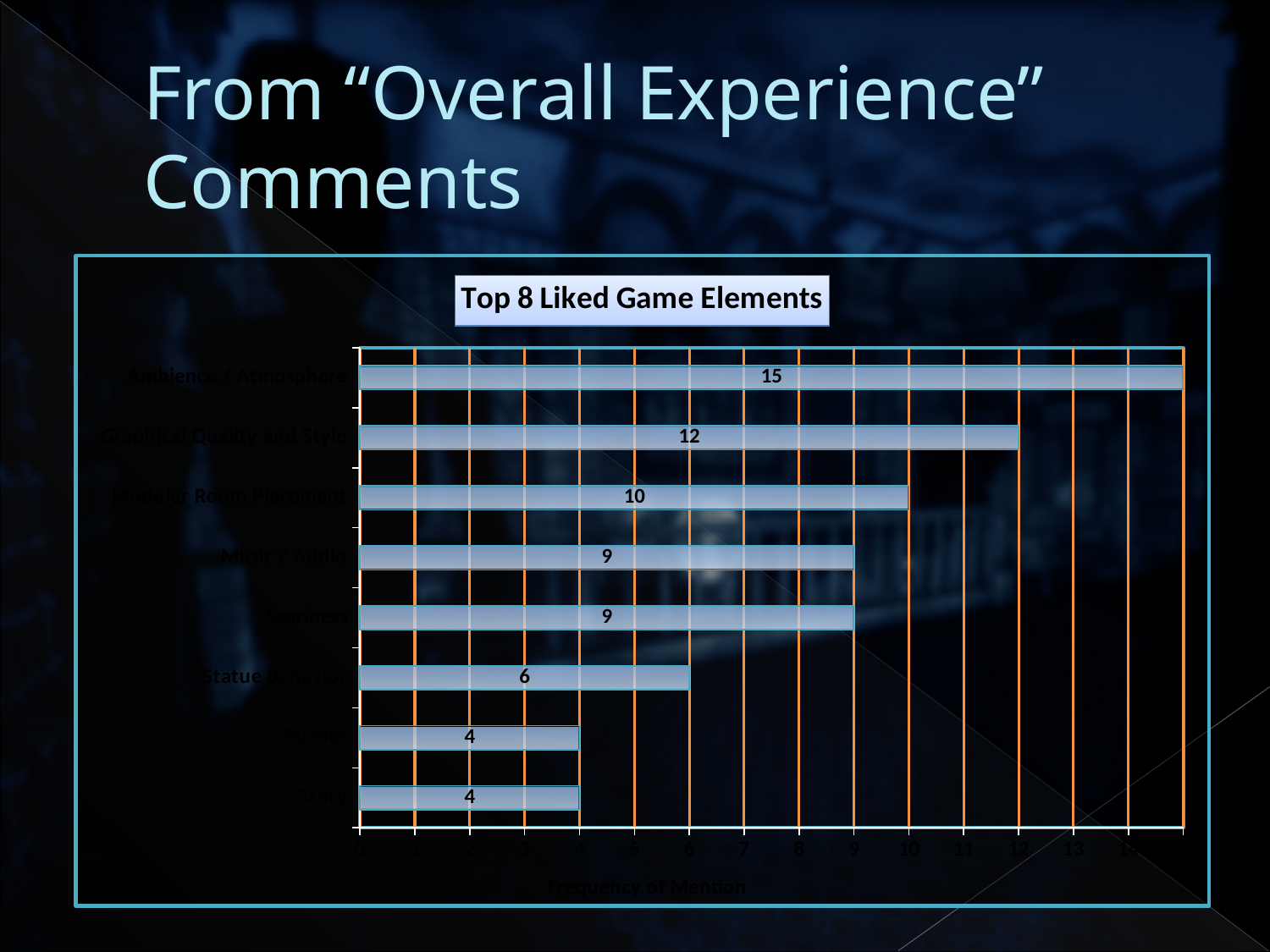
What is the title of the chart? Top 8 Liked Game Elements Is the value for Graphical Quality and Style greater or less than 10? greater What is the value for Graphical Quality and Style? 12 What is the difference between the values for Ambience / Atmosphere and Modular Room Placement? 5 Which is larger, the value for Music / Audio or the value for Statue Behavior? Music / Audio Which category has the highest frequency of mention? Ambience / Atmosphere How many categories are shown in the chart? 8 What is the label of the horizontal axis? Frequency of Mention What is the value for Statue Behavior? 6 What is the value for Puzzles? 4 What is the value for Ambience / Atmosphere? 15 What kind of chart is shown on the slide? Bar chart